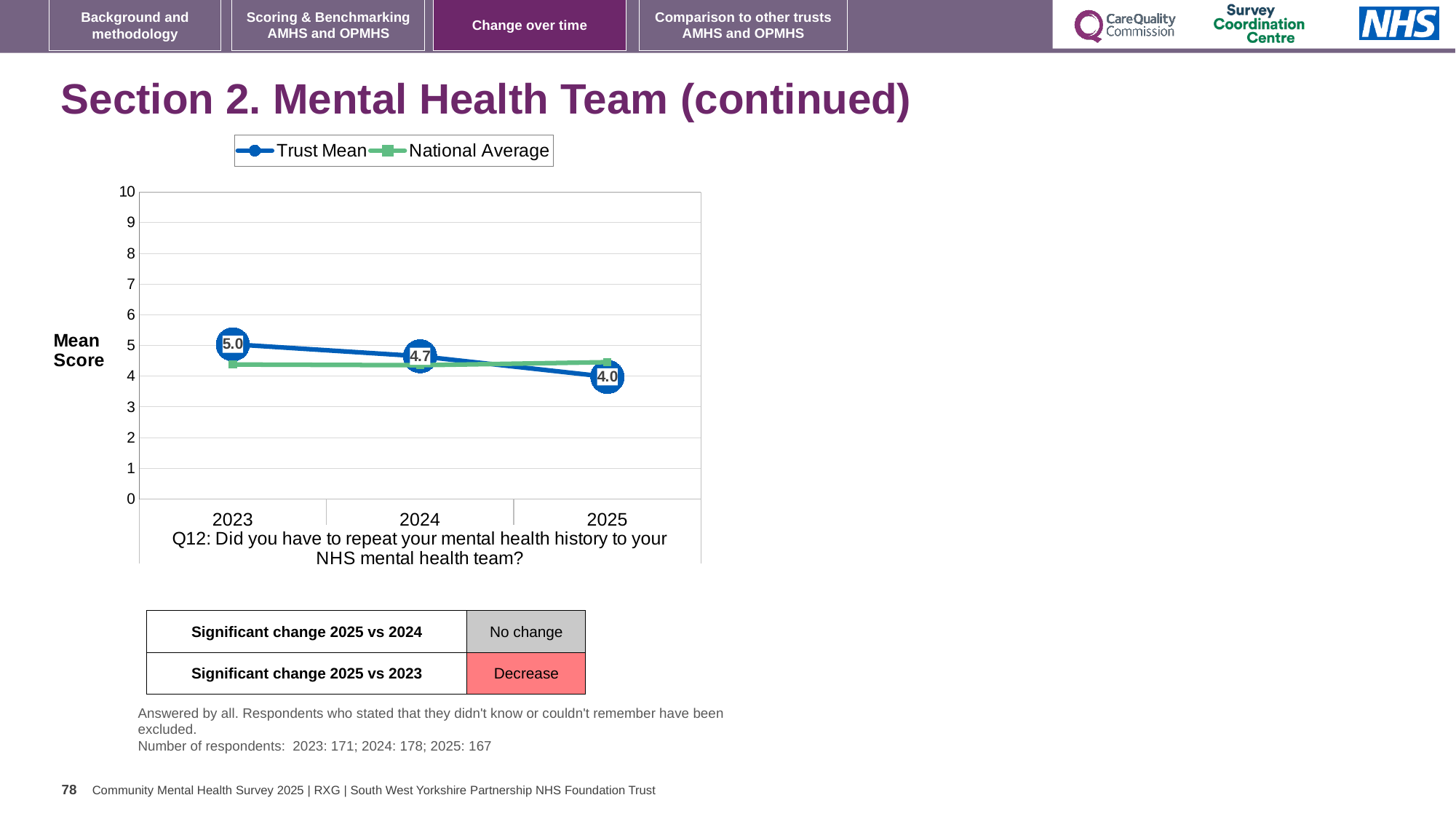
What is the difference between the Trust Mean in 2024 and in 2025? 0.7 In which year is the Trust Mean highest? 2023 What is the Trust Mean score for 2024? 4.7 In which year is the Trust Mean lowest? 2025 What is the Trust Mean score for 2023? 5.0 Is the National Average for 2023 greater or less than 5? less In 2023, which is larger: the Trust Mean or the National Average? Trust Mean What is the Trust Mean score for 2025? 4.0 In 2025, which is larger: the Trust Mean or the National Average? National Average How many series does the legend list? 2 Does the Trust Mean rise or fall from 2023 to 2025? fall What is the difference between the Trust Mean in 2023 and in 2025? 1.0